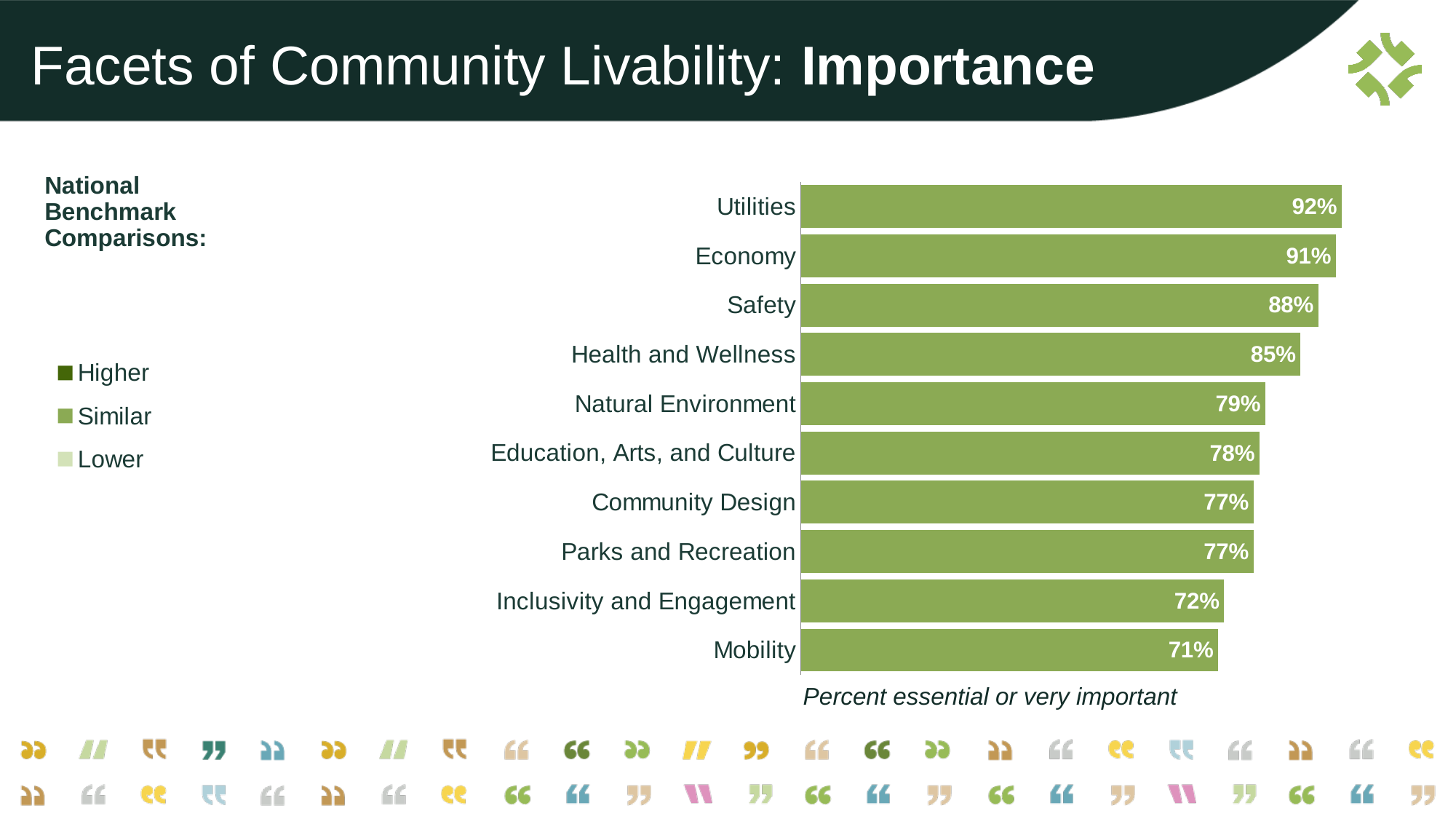
What is the difference between the values for Safety and Natural Environment? 9% How many entries does the National Benchmark Comparisons legend list? 3 What is the difference between the values for Utilities and Mobility? 21% What type of chart is shown on the slide? Bar chart Which facet has the highest percentage rated essential or very important? Utilities What is the value shown for Health and Wellness? 85% Which facet has the lowest percentage rated essential or very important? Mobility How many facets are shown in the bar chart? 10 What percentage of respondents rated Utilities as essential or very important? 92% Which has a higher value, Economy or Safety? Economy What is the caption below the chart's bars? Percent essential or very important What is the value shown for Inclusivity and Engagement? 72%